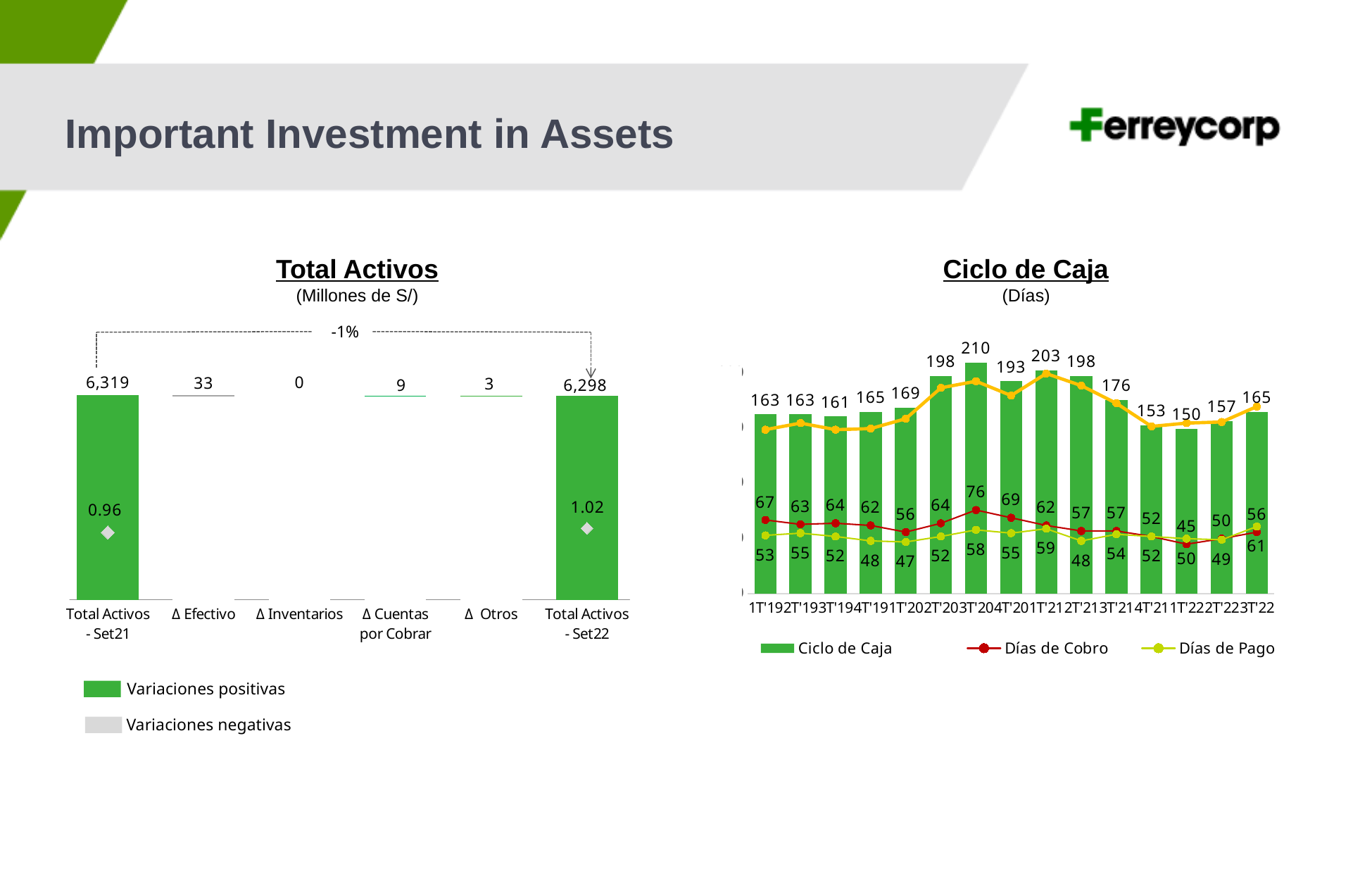
In the 'Total Activos' chart, what percentage change is shown between Set21 and Set22? -1% In the 'Total Activos' chart, what is the difference between Total Activos - Set21 and Total Activos - Set22? 21 In the 'Ciclo de Caja' chart, which quarter has the highest Ciclo de Caja value? 3T'20 In the 'Ciclo de Caja' chart, what is the Días de Cobro value for 3T'20? 76 In the 'Total Activos' chart, what is the value for Δ Efectivo? 33 In the 'Ciclo de Caja' chart, which quarter has the lowest Ciclo de Caja value? 1T'22 In the 'Total Activos' chart, what is the value for Total Activos - Set21? 6,319 In the 'Ciclo de Caja' chart, how many series does the legend list? 3 What kind of chart is the 'Total Activos' chart on the left? bar chart In the 'Ciclo de Caja' chart, how many quarters are shown on the x axis? 15 In the 'Ciclo de Caja' chart, what is the Ciclo de Caja value for 1T'21? 203 In the 'Total Activos' chart, what is the value for Total Activos - Set22? 6,298